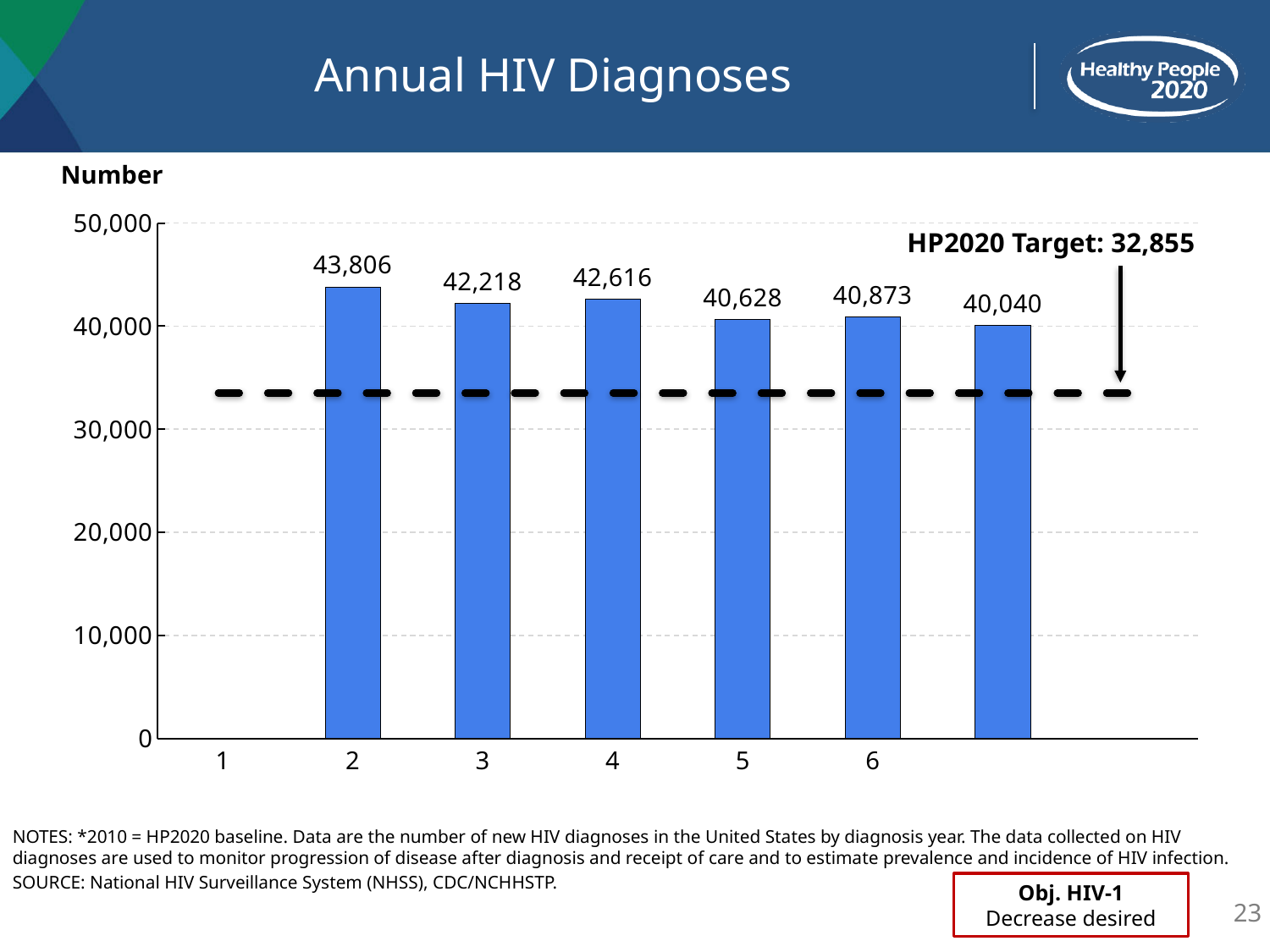
How many bars are plotted in the chart? 6 Which is larger, the second bar from the left (42,218) or the third bar from the left (42,616)? 42,616 Is the value of the fourth bar from the left greater or less than 40,000? greater What is the value shown on the leftmost bar? 43,806 What is the title of the chart? Annual HIV Diagnoses What is the value shown on the rightmost bar? 40,040 What is the HP2020 Target value shown on the chart? 32,855 What is the difference between the leftmost bar (43,806) and the rightmost bar (40,040)? 3,766 Which bar has the lowest value? the rightmost bar (40,040) What is the value shown on the third bar from the left? 42,616 Which bar has the highest value? the leftmost bar (43,806) What type of chart is shown on the slide? bar chart